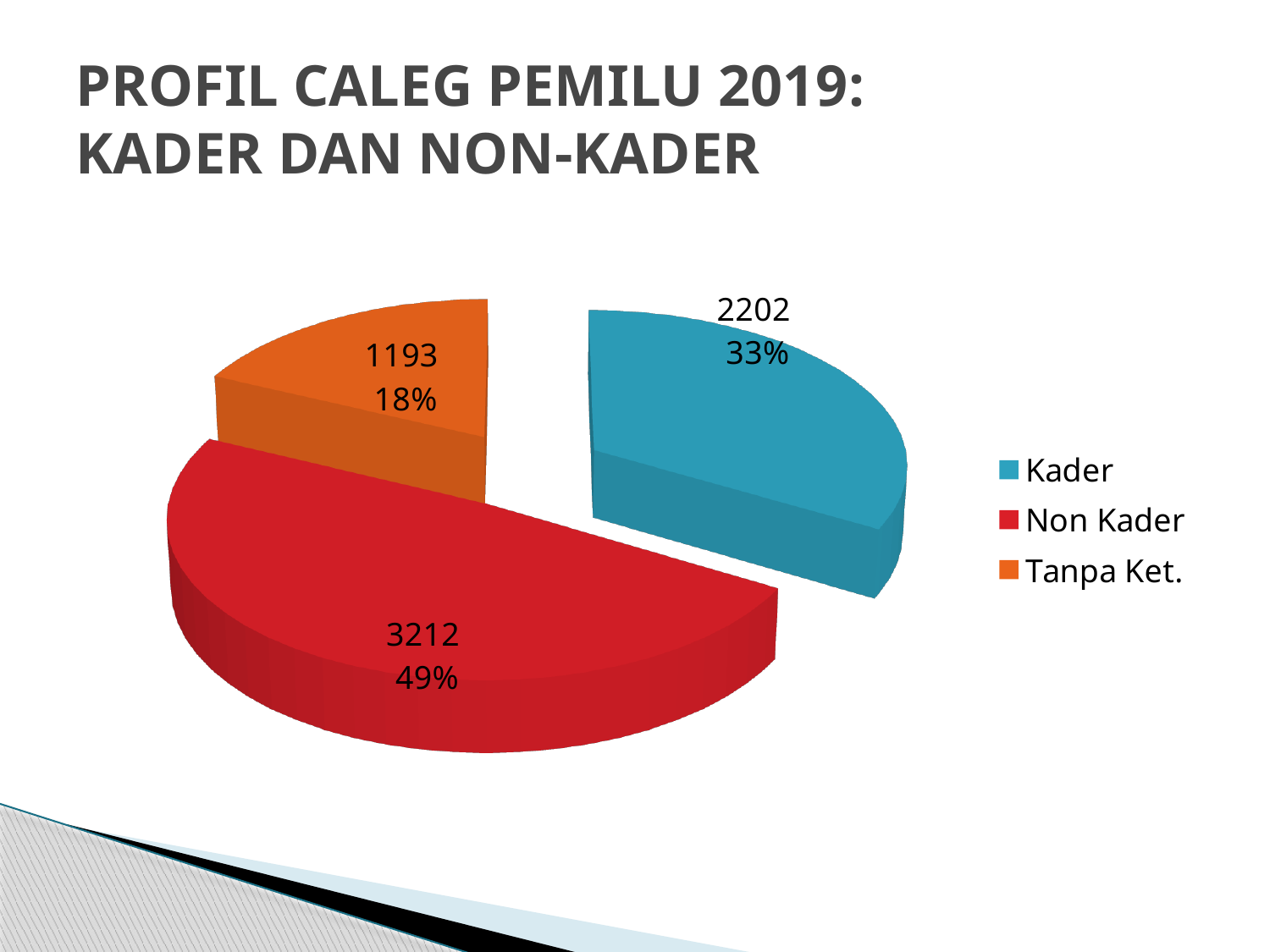
Which category has the largest slice? Non Kader What is the value for Kader? 2202 What is the value for Tanpa Ket.? 1193 Which is larger, the value for Kader or the value for Tanpa Ket.? Kader What kind of chart is shown on the slide? pie chart What percentage share does the Tanpa Ket. slice have? 18% What is the difference between the values for Non Kader and Kader? 1010 What percentage share does the Kader slice have? 33% How many categories does the legend list? 3 What is the value for Non Kader? 3212 Which category has the smallest slice? Tanpa Ket. What percentage share does the Non Kader slice have? 49%